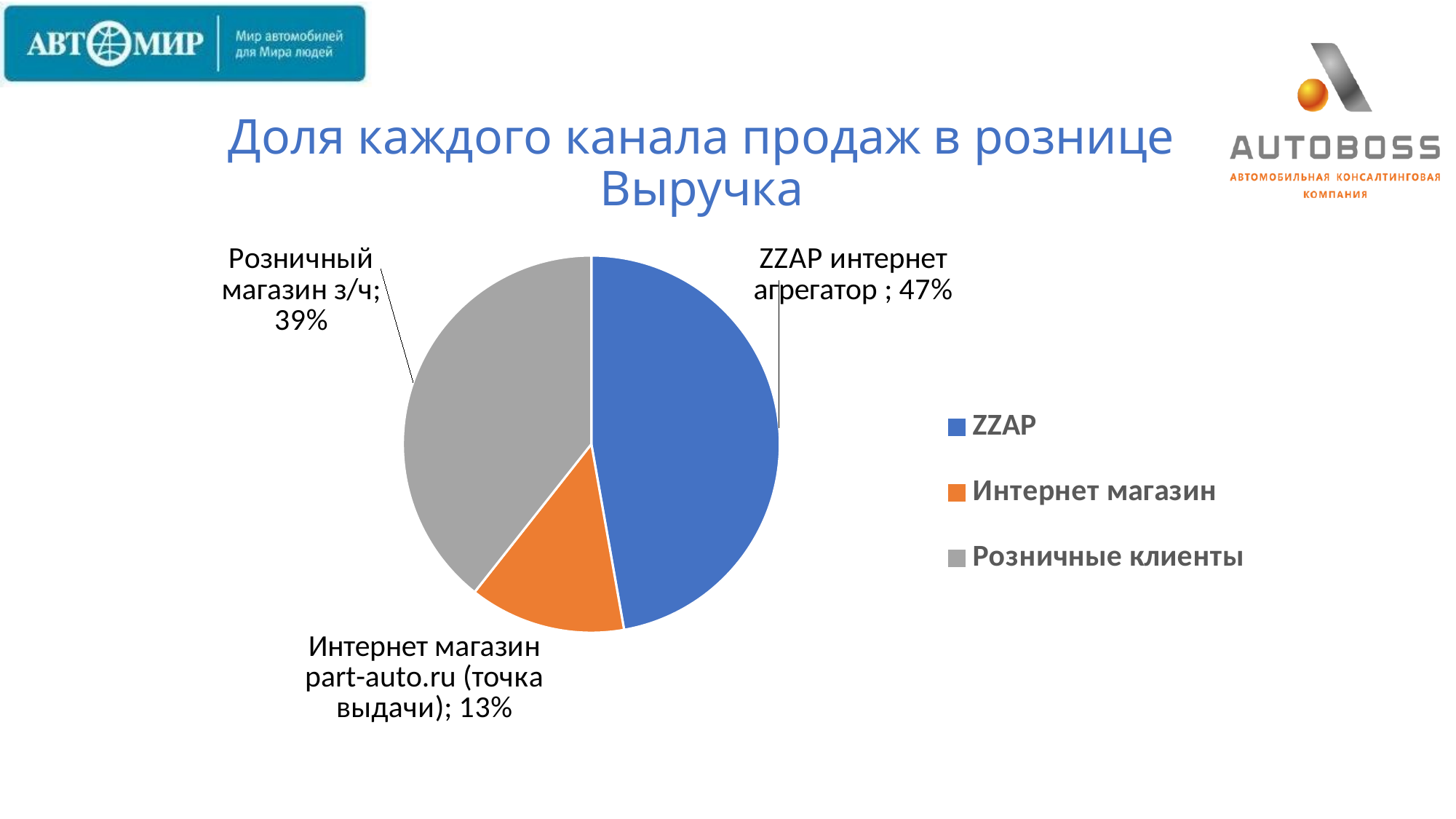
Which sales channel has the largest share of revenue? ZZAP интернет агрегатор Which is larger: the share for Розничный магазин з/ч or the share for Интернет магазин part-auto.ru? Розничный магазин з/ч What share of revenue does the ZZAP internet aggregator slice represent? 47% What share of revenue does the Розничный магазин з/ч slice represent? 39% Which sales channel has the smallest share of revenue? Интернет магазин part-auto.ru (точка выдачи) What colour is the slice for Розничные клиенты in the legend? grey How many slices does the pie chart have? 3 What share of revenue does the Интернет магазин part-auto.ru (точка выдачи) slice represent? 13% How many entries does the legend list? 3 What is the difference in percentage points between the ZZAP slice and the Розничный магазин з/ч slice? 8 What kind of chart is shown on the slide? pie chart What is the difference in percentage points between the Розничный магазин з/ч slice and the Интернет магазин part-auto.ru slice? 26